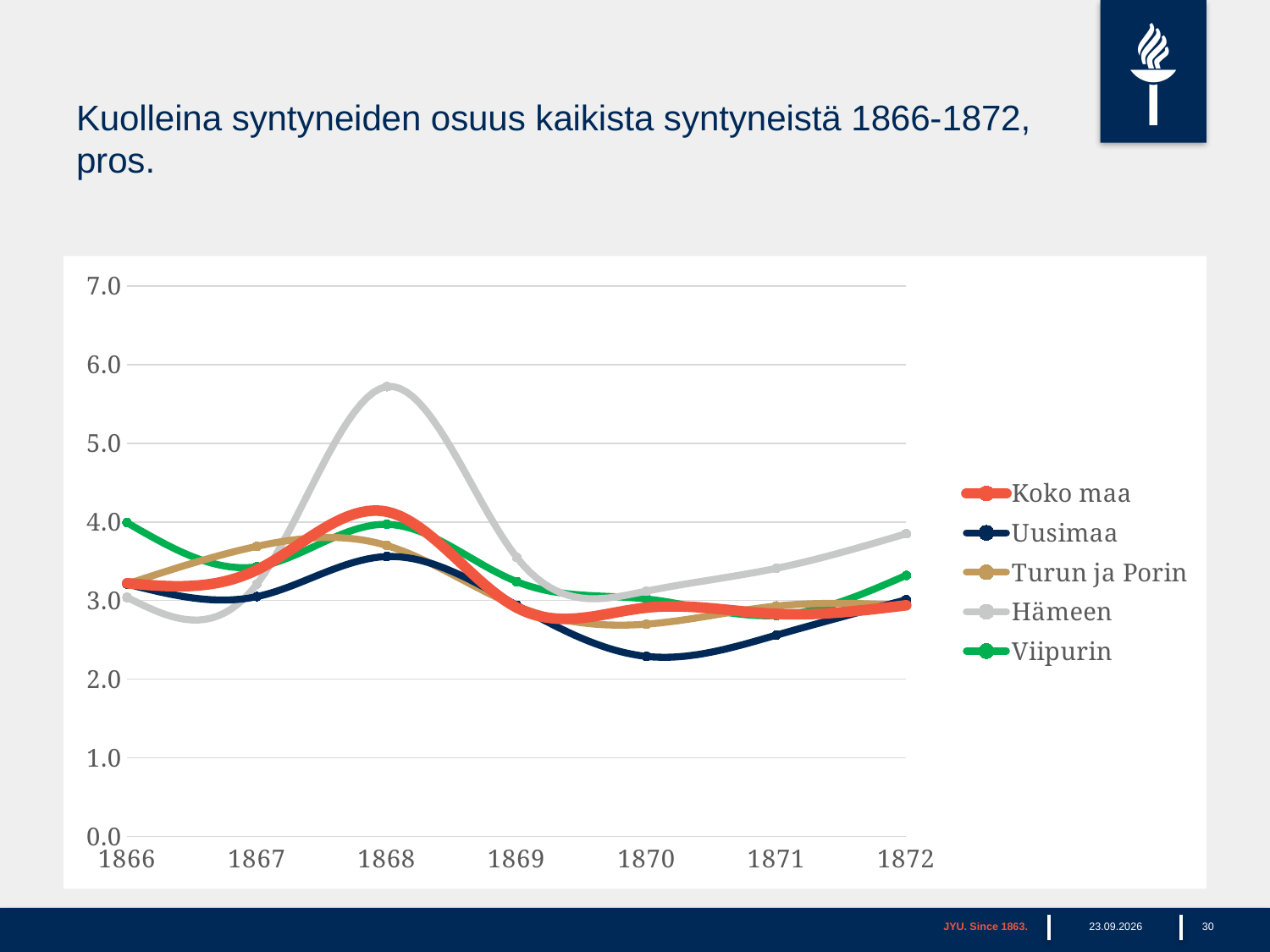
Is the value for Uusimaa in 1870 greater or less than 3.0? less Which series is drawn in green? Viipurin How many series does the legend list? 5 Which series reaches the highest value in 1868? Hämeen Which is larger in 1868, the value for Hämeen or the value for Uusimaa? Hämeen Is the value for Hämeen in 1867 greater or less than 3.0? greater In which year does the Hämeen series reach its highest value? 1868 Does the Hämeen series rise or fall from 1870 to 1872? rise How many years are shown along the x axis? 7 Is the value for Hämeen in 1868 greater or less than 5.0? greater What kind of chart is shown on the slide? line chart Which series has the lowest value in 1870? Uusimaa